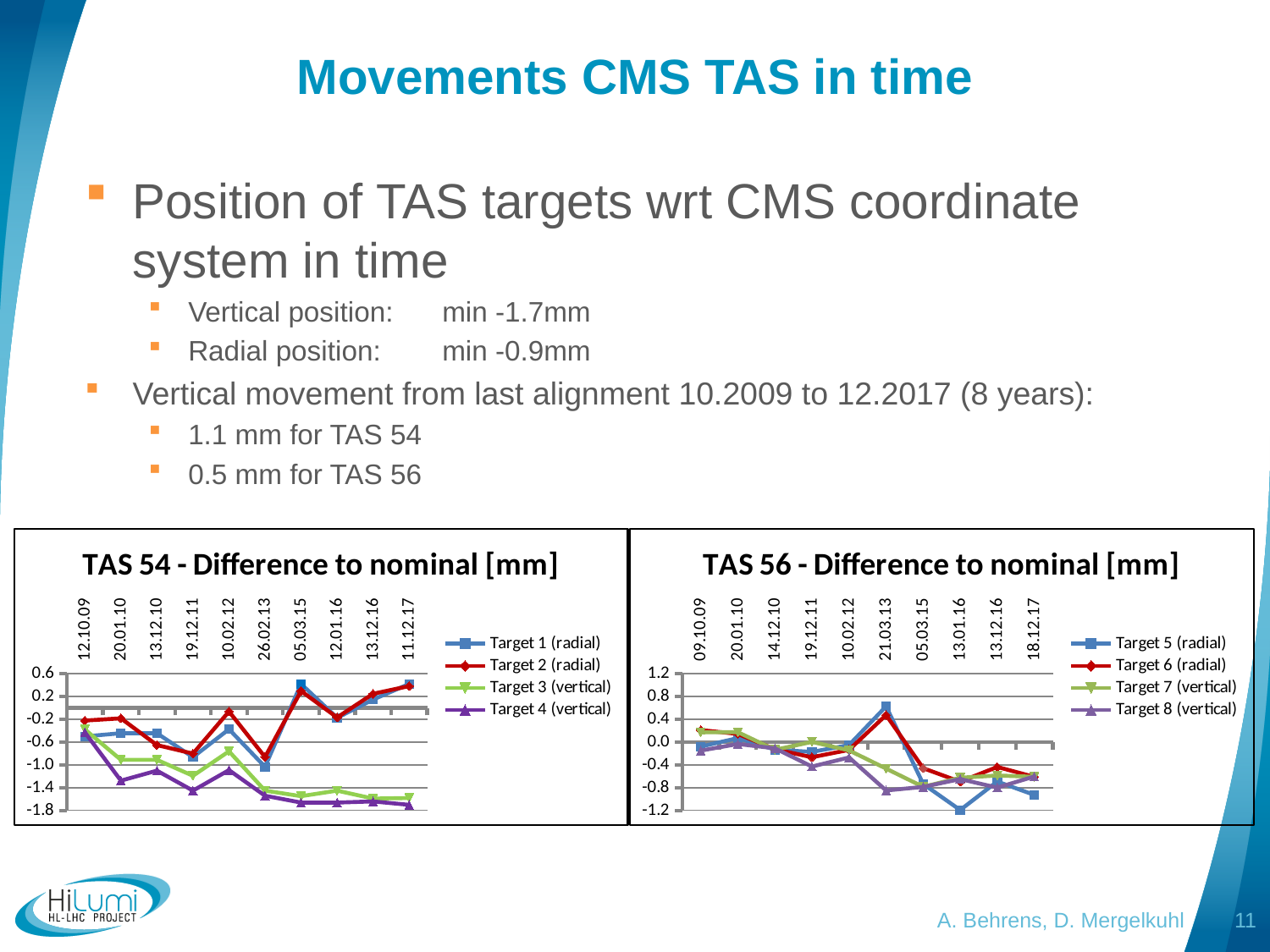
In the 'TAS 54 - Difference to nominal [mm]' chart, is the value for Target 4 (vertical) at 11.12.17 greater or less than -1.4? less What is the first date on the x axis of the 'TAS 56 - Difference to nominal [mm]' chart? 09.10.09 In the 'TAS 56 - Difference to nominal [mm]' chart, is the value for Target 8 (vertical) at 21.03.13 greater or less than -0.4? less How many dates are shown on the x axis of the 'TAS 54 - Difference to nominal [mm]' chart? 10 In the 'TAS 54 - Difference to nominal [mm]' chart, is the value for Target 1 (radial) at 05.03.15 greater or less than 0.2? greater In the 'TAS 56 - Difference to nominal [mm]' chart, which series reaches the lowest value on the chart? Target 5 (radial) How many series does the legend of the 'TAS 56 - Difference to nominal [mm]' chart list? 4 In the 'TAS 54 - Difference to nominal [mm]' chart, at 11.12.17 which is higher, Target 1 (radial) or Target 4 (vertical)? Target 1 (radial) In the 'TAS 54 - Difference to nominal [mm]' chart, does Target 4 (vertical) overall rise or fall from 12.10.09 to 11.12.17? fall What kind of chart is the 'TAS 54 - Difference to nominal [mm]' chart? line chart In the 'TAS 54 - Difference to nominal [mm]' chart, which series are labelled as vertical in the legend? Target 3 (vertical) and Target 4 (vertical)